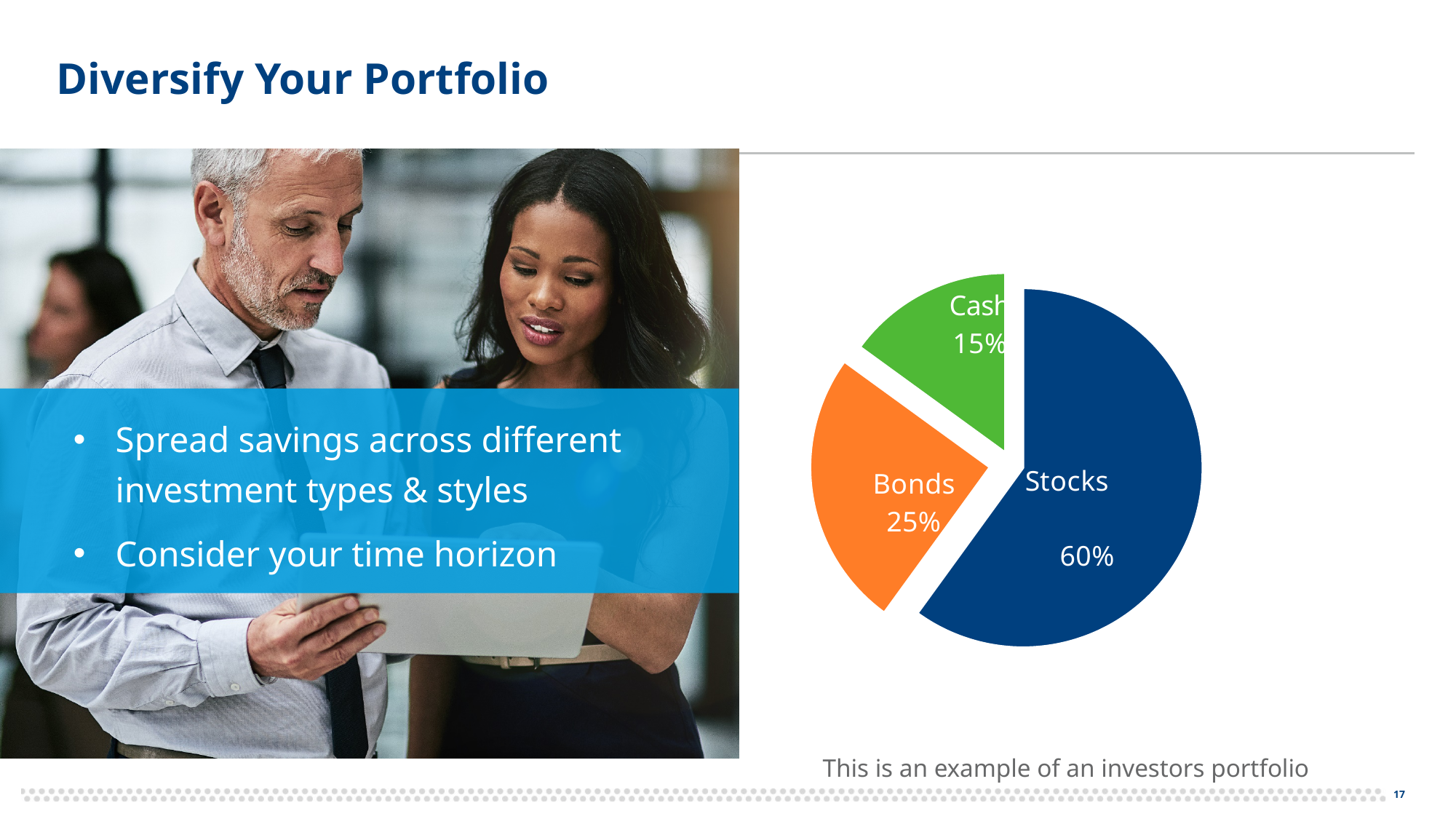
Which slice of the pie chart is the largest? Stocks What colour is the Stocks slice in the pie chart? dark blue What share of the portfolio is allocated to Bonds? 25% Which slice of the pie chart is the smallest? Cash What kind of chart is shown on the slide? pie chart What colour is the Cash slice in the pie chart? green Which is larger, the Bonds slice or the Cash slice? Bonds What is the difference in percentage points between the Stocks and Bonds slices? 35 What is the difference in percentage points between the Bonds and Cash slices? 10 How many slices does the pie chart have? 3 What share of the portfolio is allocated to Stocks? 60% What share of the portfolio is allocated to Cash? 15%